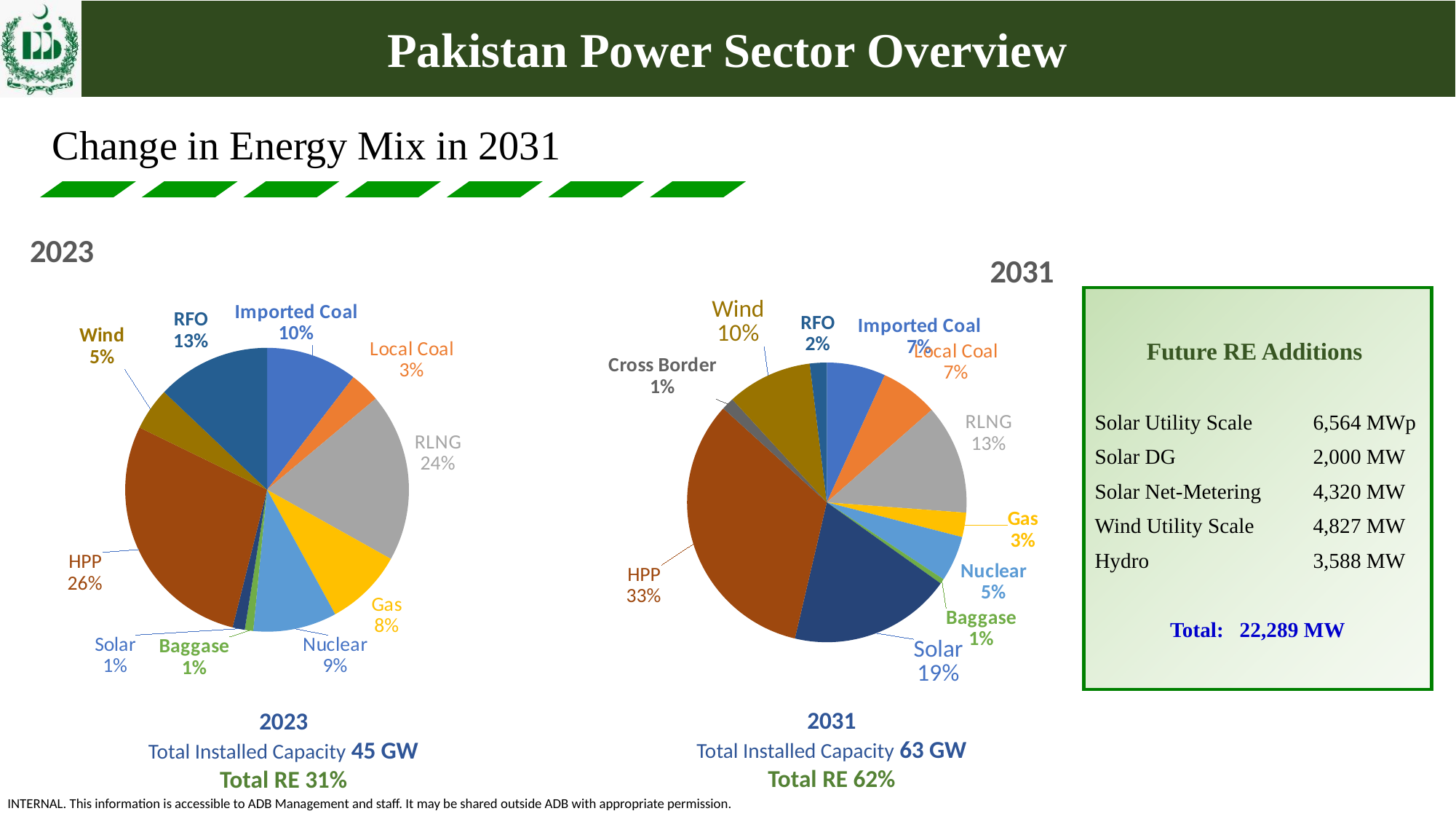
In the 2031 pie chart, which category has the largest share? HPP What is the difference between the HPP share in the 2031 pie chart and the HPP share in the 2023 pie chart? 7% How many categories are shown in the 2023 pie chart? 10 In the 2023 pie chart, which is larger: the share for RFO or the share for Imported Coal? RFO In the 2031 pie chart, what share does Cross Border have? 1% In the 2023 pie chart, which category has the largest share? HPP In the 2023 pie chart, what share does RLNG have? 24% What type of chart is used to show the 2023 energy mix? Pie chart In the 2031 pie chart, what share does Solar have? 19% How many categories are shown in the 2031 pie chart? 11 What is the total installed capacity stated below the 2031 pie chart? 63 GW In the 2031 pie chart, which is larger: the share for Wind or the share for Nuclear? Wind